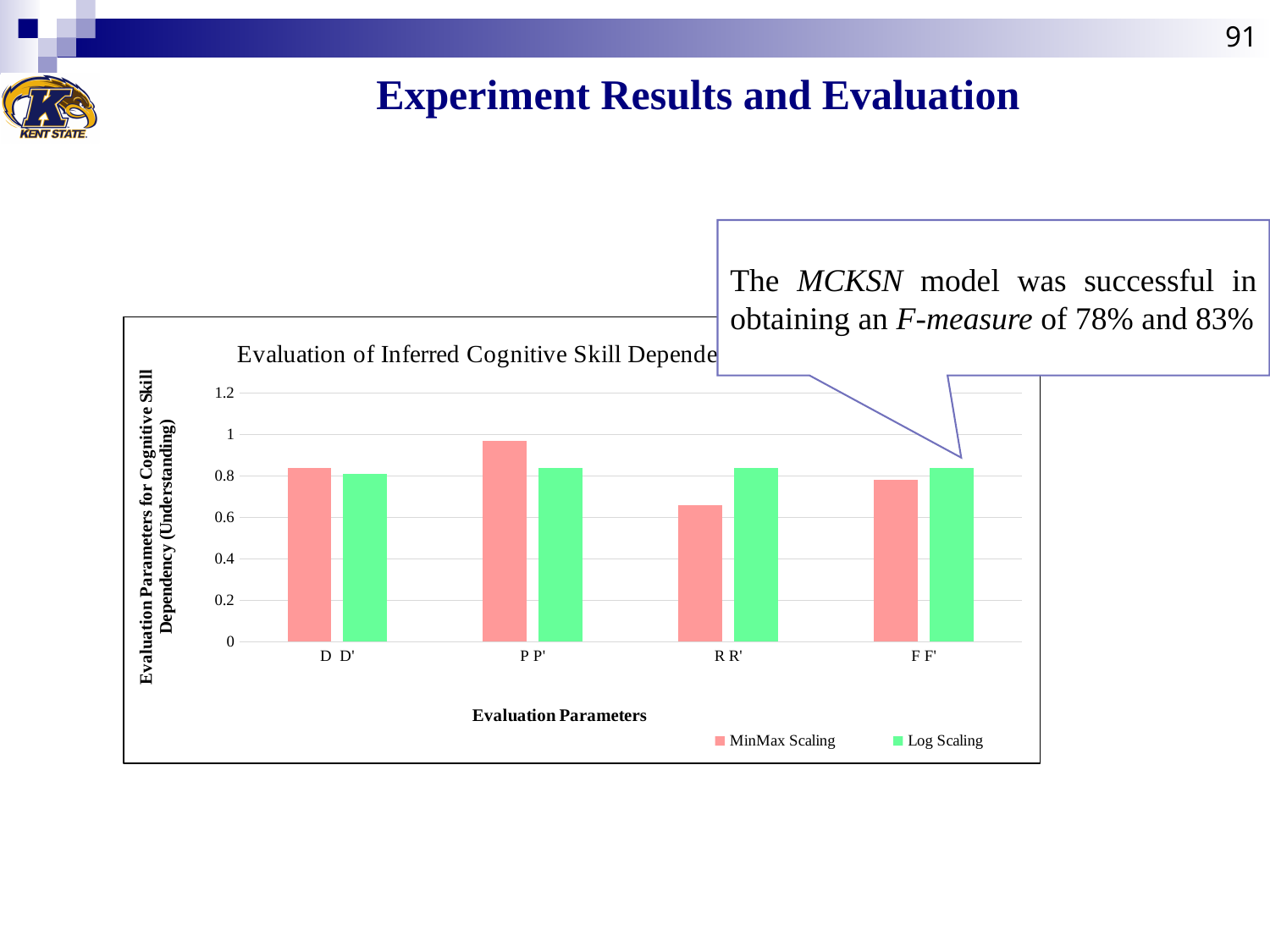
Is the MinMax Scaling value for R R' greater or less than 0.8? less Is the MinMax Scaling value for R R' greater or less than 0.6? greater Which category has the highest MinMax Scaling value? P P' What are the two series named in the chart's legend? MinMax Scaling and Log Scaling Is the MinMax Scaling value for P P' greater or less than 0.8? greater For the category R R', which series has the larger value, MinMax Scaling or Log Scaling? Log Scaling What is the title of the x axis of the chart? Evaluation Parameters How many categories are shown on the x axis of the chart? 4 How many series does the chart's legend list? 2 What kind of chart is shown on the slide? bar chart Which category has the lowest MinMax Scaling value? R R' For the category P P', which series has the larger value, MinMax Scaling or Log Scaling? MinMax Scaling